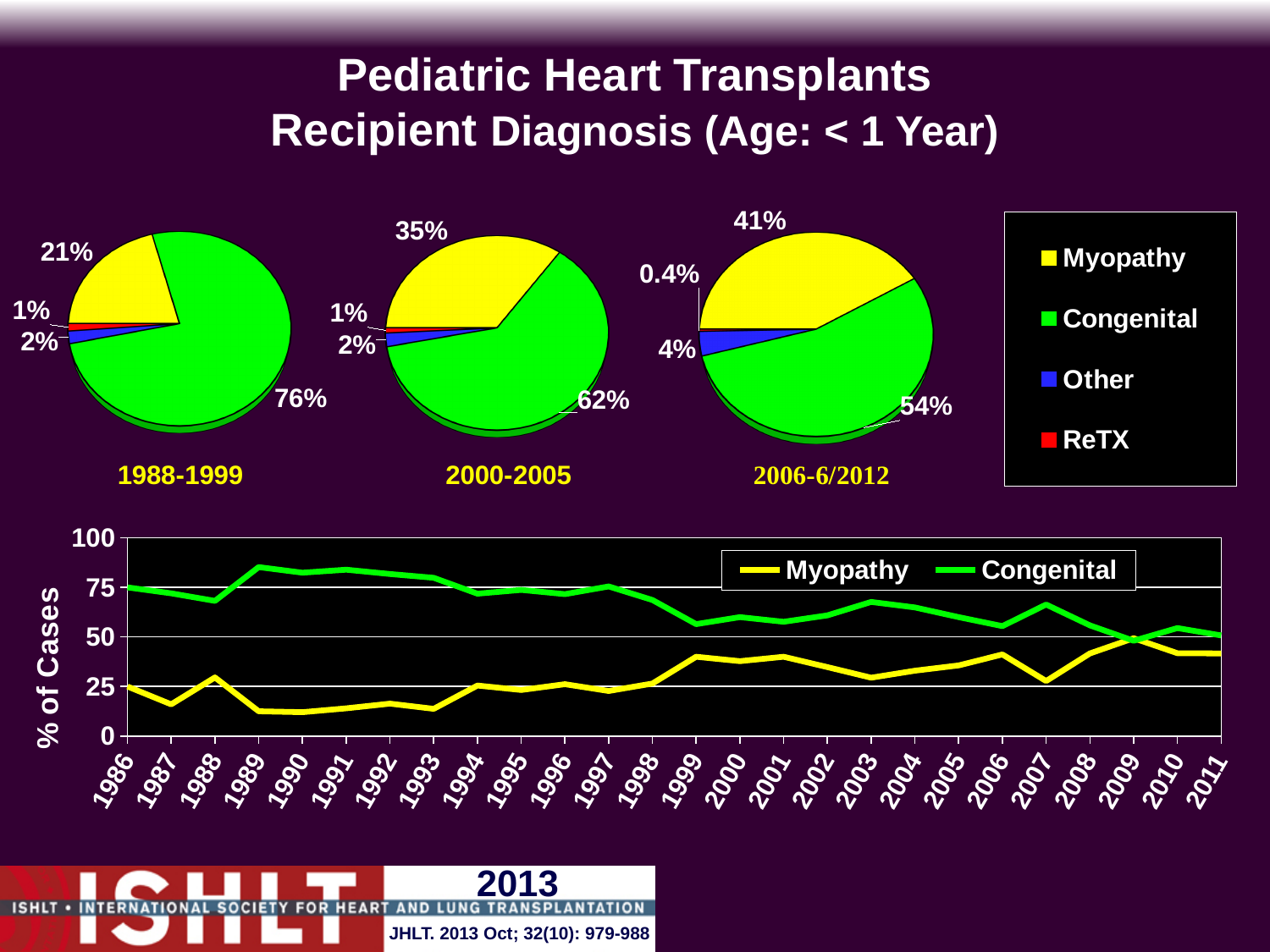
In the 1988-1999 pie chart, which diagnosis has the smallest share? ReTX In the 2000-2005 pie chart, what percentage is Myopathy? 35% What kind of chart is shown at the bottom of the slide? Line chart How many series does the legend of the pie charts list? 4 In the 2006-6/2012 pie chart, what percentage is ReTX? 0.4% In the 2006-6/2012 pie chart, which diagnosis has the largest share? Congenital In the line chart, does the Congenital line generally rise or fall from 1989 to 2011? fall In the line chart, is the Myopathy value for 1990 greater or less than 25? less In the 1988-1999 pie chart, what percentage is Congenital? 76% Comparing the 1988-1999 and 2006-6/2012 pie charts, which period has the larger Myopathy share? 2006-6/2012 In the line chart, is the Congenital value for 1989 greater or less than 75? greater In the 2006-6/2012 pie chart, what is the difference between the Congenital and Myopathy percentages? 13%